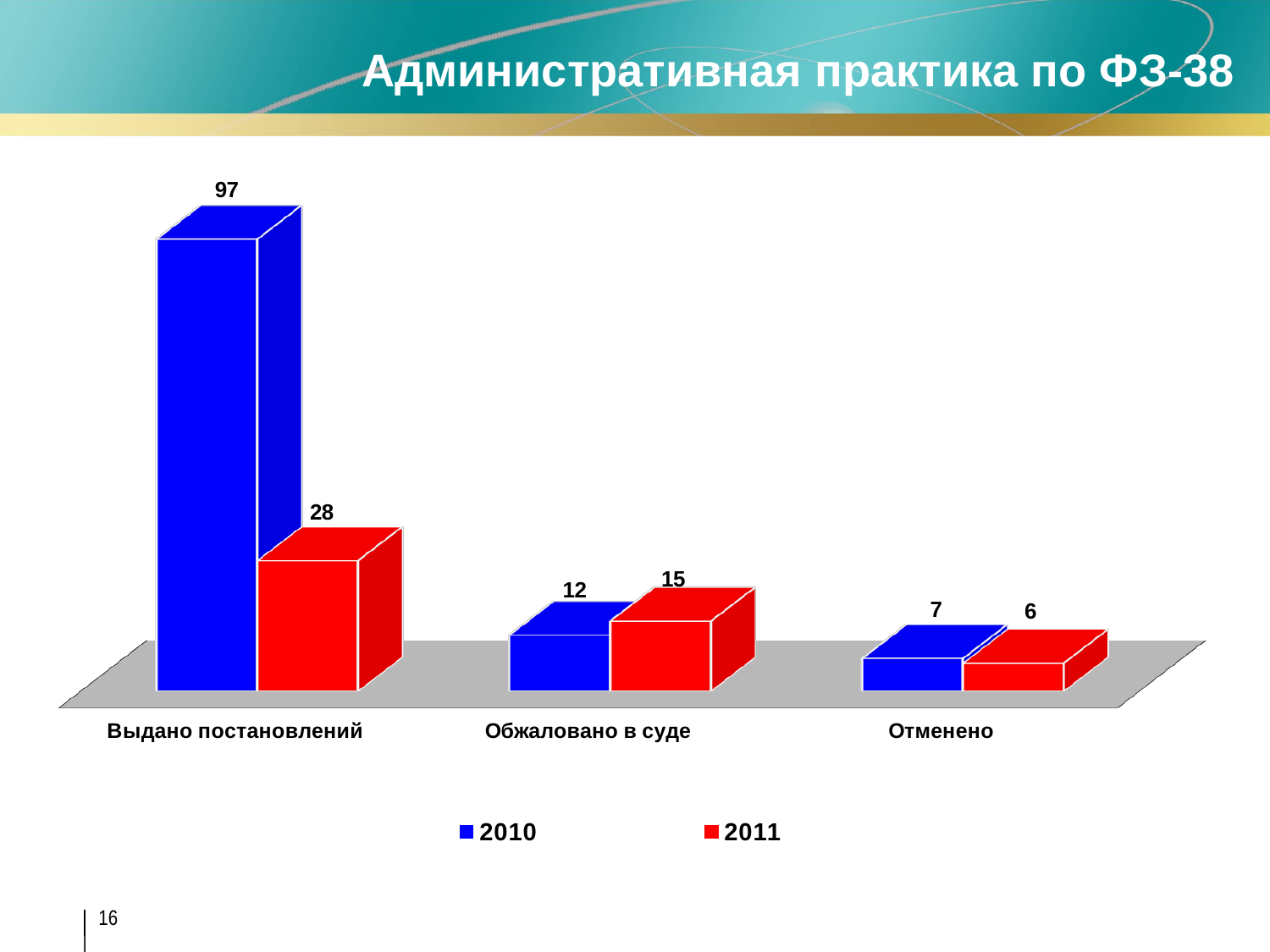
What is the value for 2011 in the "Обжаловано в суде" category? 15 What is the value for 2010 in the "Выдано постановлений" category? 97 What is the value for 2011 in the "Отменено" category? 6 Which category has the lowest value for the 2011 series? Отменено What kind of chart is shown on the slide? Bar chart How many series does the legend list? 2 Which category has the highest value for the 2010 series? Выдано постановлений Which colour represents the 2011 series? Red What is the difference between the 2010 and 2011 values in the "Выдано постановлений" category? 69 How many categories are shown on the x axis? 3 What is the difference between the 2011 and 2010 values in the "Обжаловано в суде" category? 3 Which is larger in the "Обжаловано в суде" category: the 2010 value or the 2011 value? 2011